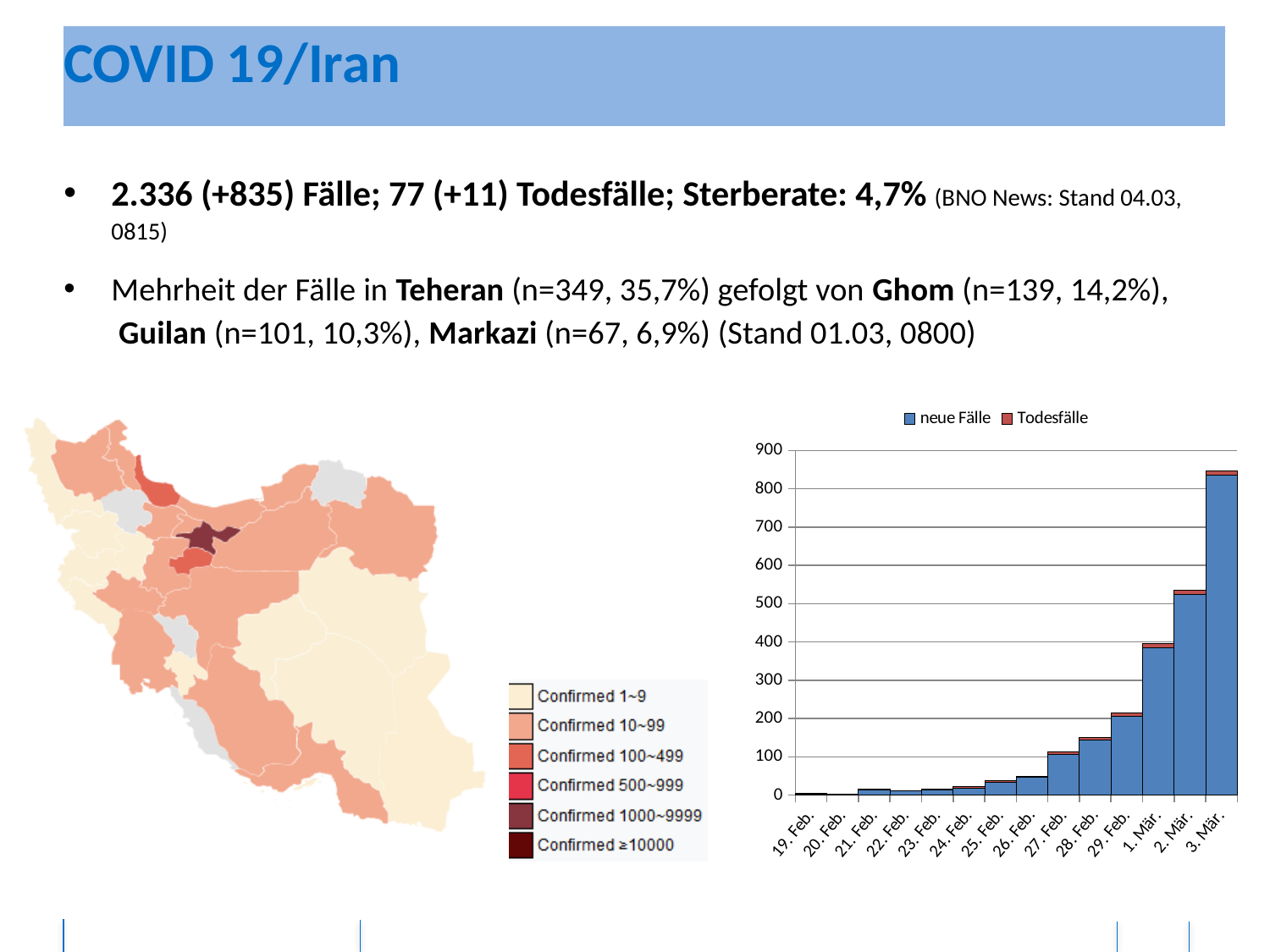
Which two series are listed in the legend of the bar chart? neue Fälle and Todesfälle Do the bars in the chart generally rise or fall from 19. Feb. to 3. Mär.? rise Is the total bar for 2. Mär. greater or less than 500? greater How many series does the legend of the bar chart list? 2 Which bar is taller in the chart, 2. Mär. or 1. Mär.? 2. Mär. Is the total bar for 26. Feb. greater or less than 100? less What colour represents the series "Todesfälle" in the bar chart? red How many dates are shown along the x axis of the bar chart? 14 What kind of chart is shown on the right side of the slide? bar chart Is the total bar for 3. Mär. greater or less than 800? greater Which date has the highest bar in the bar chart? 3. Mär.